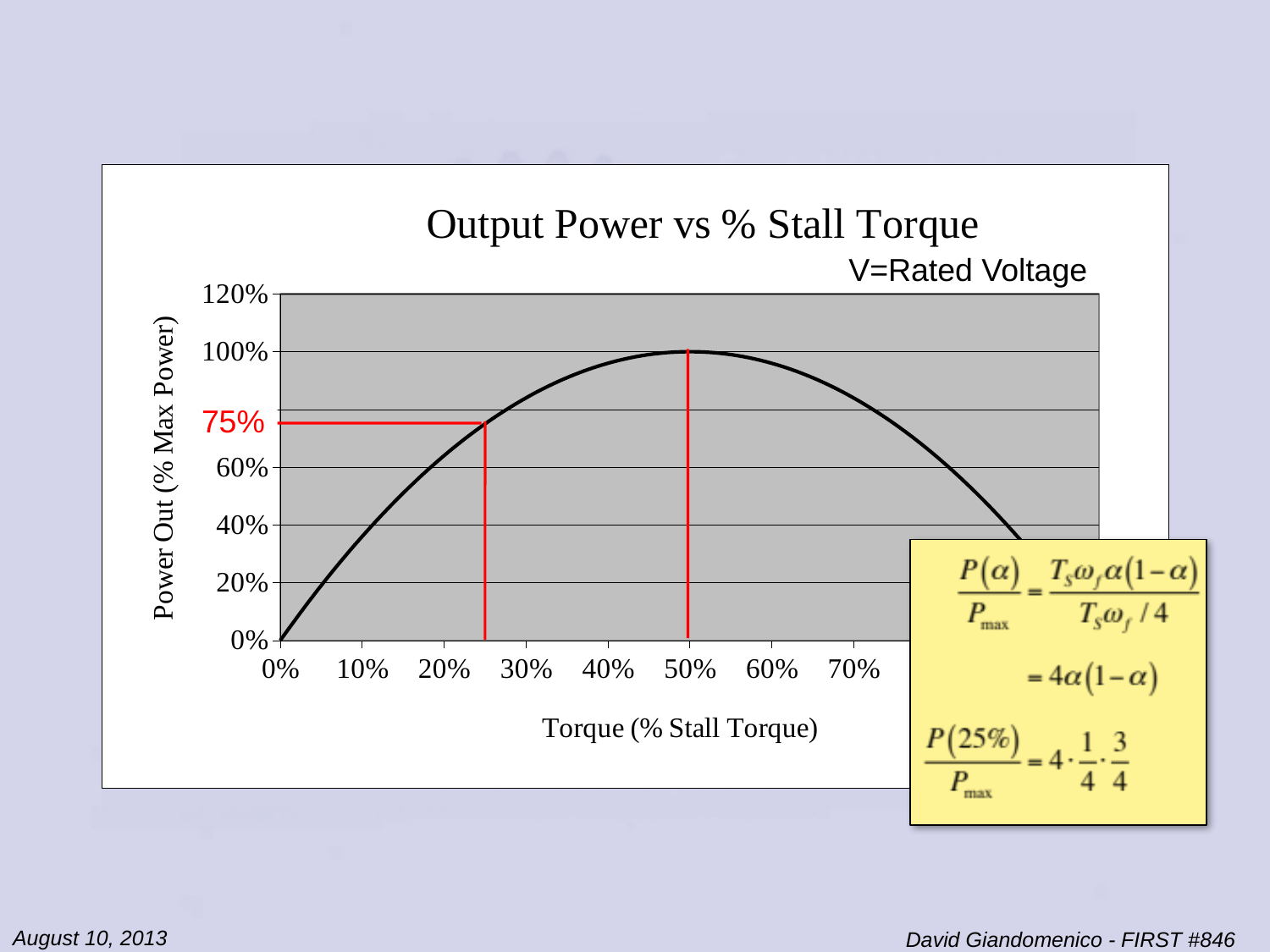
What is the difference between the power out at 50% torque and the power out at 25% torque? 25% What is the title of the chart? Output Power vs % Stall Torque Is the power out at 70% stall torque greater or less than 60%? greater Does the power out rise or fall as torque increases from 0% to 50%? rise What is the power out (% max power) at 50% stall torque? 100% What is the power out (% max power) at 25% stall torque, as marked in red? 75% At what torque (% stall torque) does the output power reach its highest value? 50% Does the power out rise or fall as torque increases from 50% to 70%? fall Which torque value gives the larger power out: 25% or 50%? 50% What kind of chart is shown on the slide? line chart What is the label of the x axis? Torque (% Stall Torque) Is the power out at 20% stall torque greater or less than 40%? greater